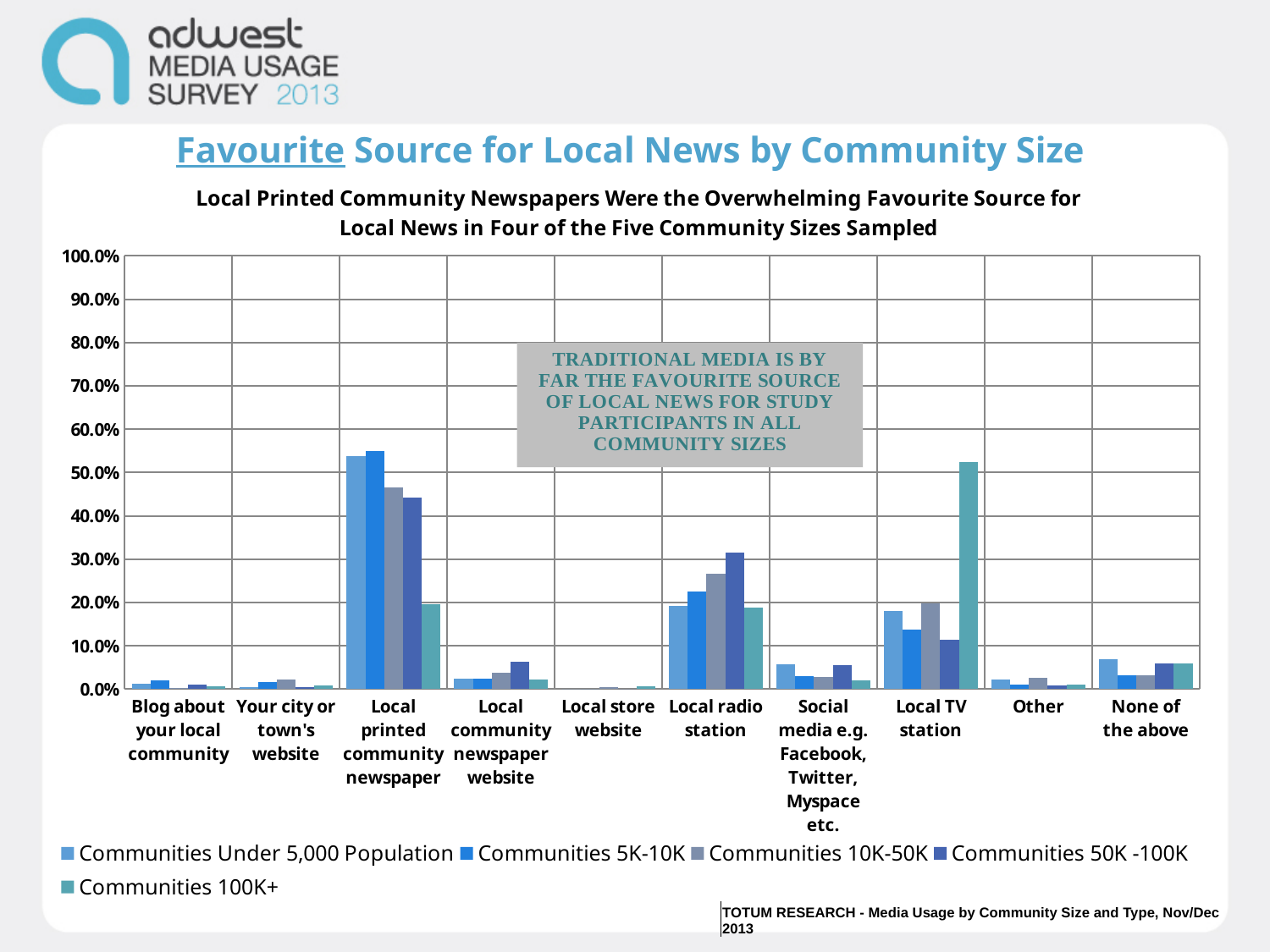
Is the value for Local printed community newspaper for Communities 100K+ greater or less than 30%? less How many series does the legend list? 5 Is the value for Local TV station for Communities 100K+ greater or less than 40%? greater Is the value for Local printed community newspaper for Communities 5K-10K greater or less than 50%? greater For Communities Under 5,000 Population, which category has the highest value? Local printed community newspaper For Local radio station, which is larger: the value for Communities 50K -100K or for Communities Under 5,000 Population? Communities 50K -100K How many categories are shown along the x axis? 10 What kind of chart is shown on the slide? bar chart For Communities 100K+, which category has the highest value? Local TV station For Local TV station, which is larger: the value for Communities 100K+ or for Communities 5K-10K? Communities 100K+ What is the title of the chart? Local Printed Community Newspapers Were the Overwhelming Favourite Source for Local News in Four of the Five Community Sizes Sampled